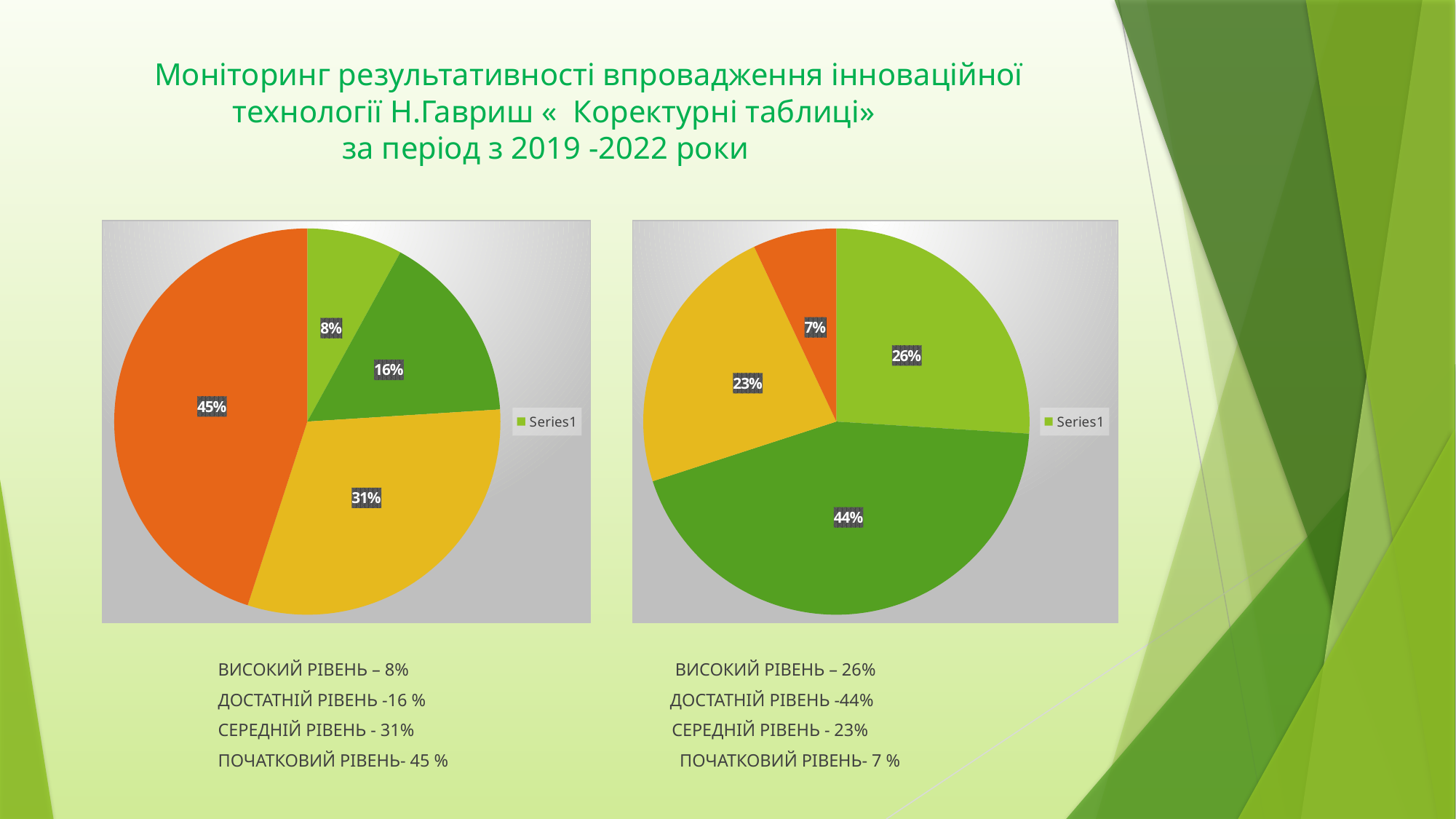
What is the difference between the largest and smallest slices in the right pie chart? 37% In the left pie chart, what is the largest slice's value? 45% In the right pie chart, what is the largest slice's value? 44% What kind of chart is the left chart on the slide? pie chart According to the text under the left pie chart, what share is ПОЧАТКОВИЙ РІВЕНЬ? 45% Which is larger: the 31% slice in the left pie chart or the 23% slice in the right pie chart? the 31% slice in the left pie chart How many slices does the right pie chart have? 4 How many series does the legend of the right pie chart list? 1 In the right pie chart, what is the smallest slice's value? 7% How many slices does the left pie chart have? 4 According to the text under the right pie chart, what share is ДОСТАТНІЙ РІВЕНЬ? 44% In the left pie chart, what is the smallest slice's value? 8%